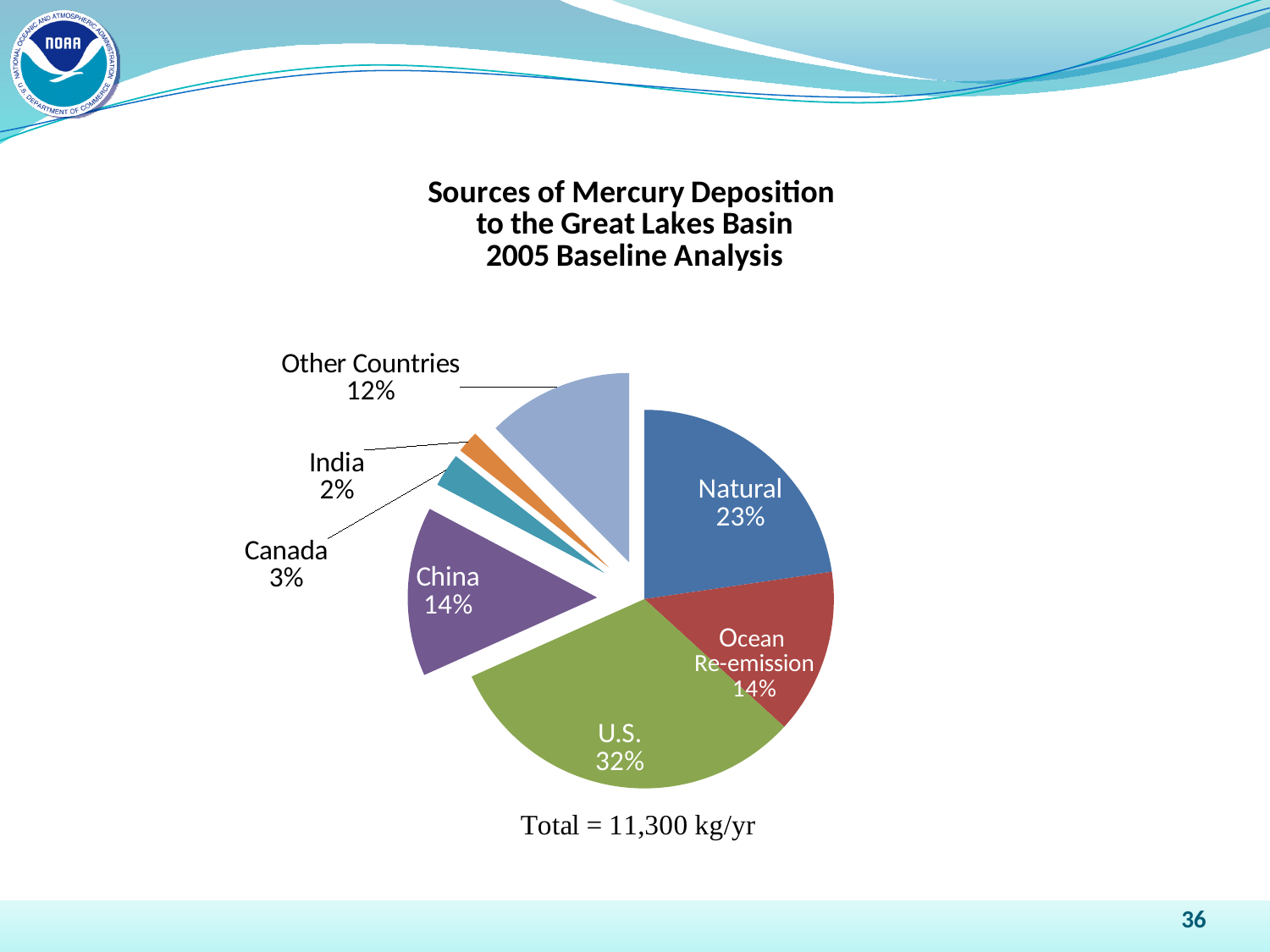
What percentage is shown for Canada? 3% Which source has the largest share of the pie? U.S. What is the difference in percentage points between the U.S. share and the Natural share? 9 What share of mercury deposition is attributed to Natural sources? 23% Which is larger, the share for Other Countries or the share for Canada? Other Countries What percentage is shown for China? 14% Which source has the smallest share of the pie? India What percentage is shown for India? 2% What total deposition is stated below the pie chart? 11,300 kg/yr What share of mercury deposition comes from the U.S.? 32% What kind of chart is shown on the slide? Pie chart How many slices does the pie chart have? 7